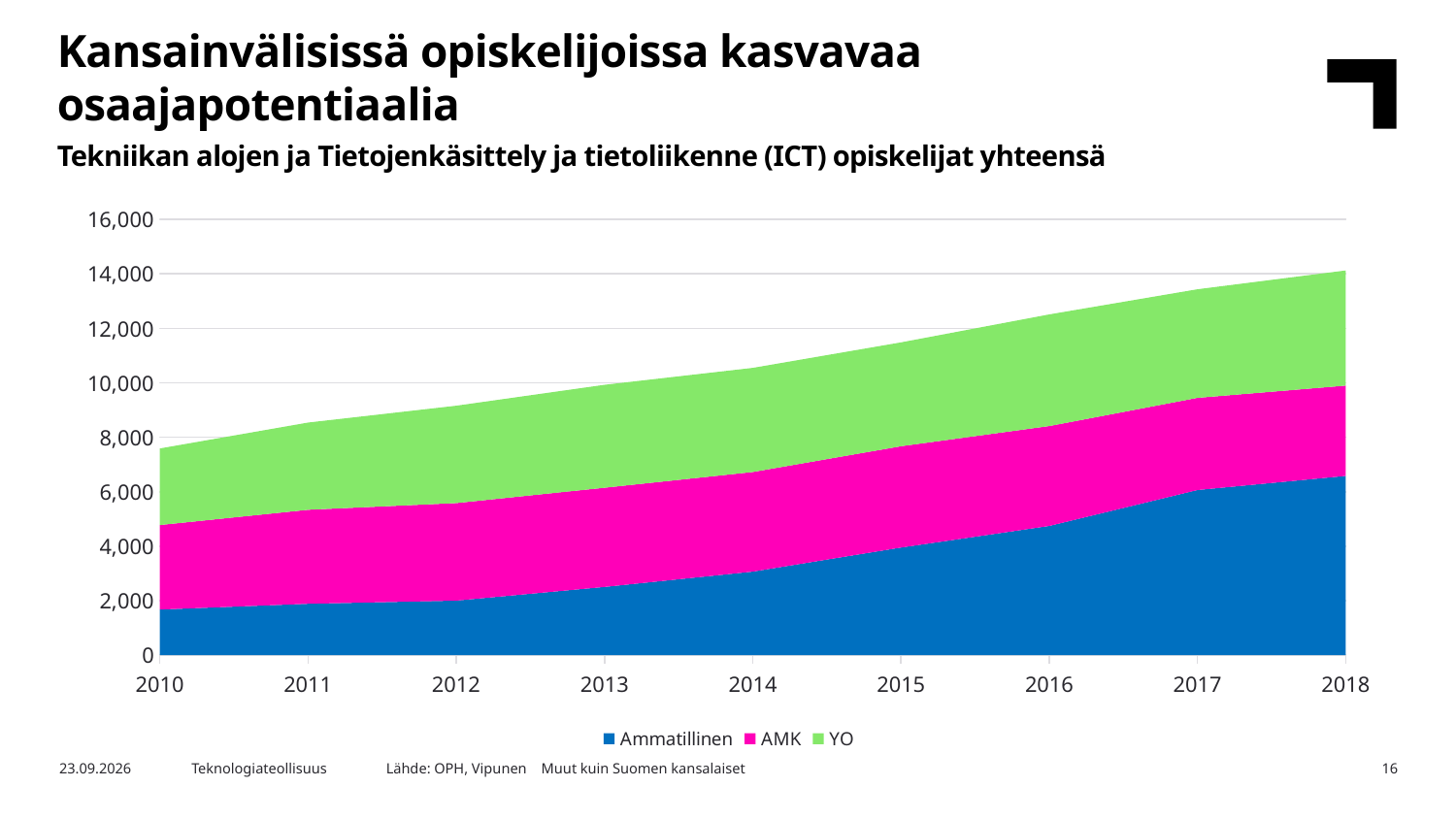
In which year is the total number of students lowest? 2010 In which year is the total number of students highest? 2018 Which is larger: the Ammatillinen value in 2018 or in 2010? 2018 How many series does the legend list? 3 Is the total number of students in 2010 greater or less than 8,000? less Is the total number of students in 2014 greater or less than 10,000? greater Is the value for Ammatillinen in 2010 greater or less than 2,000? less Which series is shown in green? YO How many years are plotted along the x axis? 9 What kind of chart is shown on the slide? Stacked area chart Does the total number of students rise or fall from 2010 to 2018? Rise